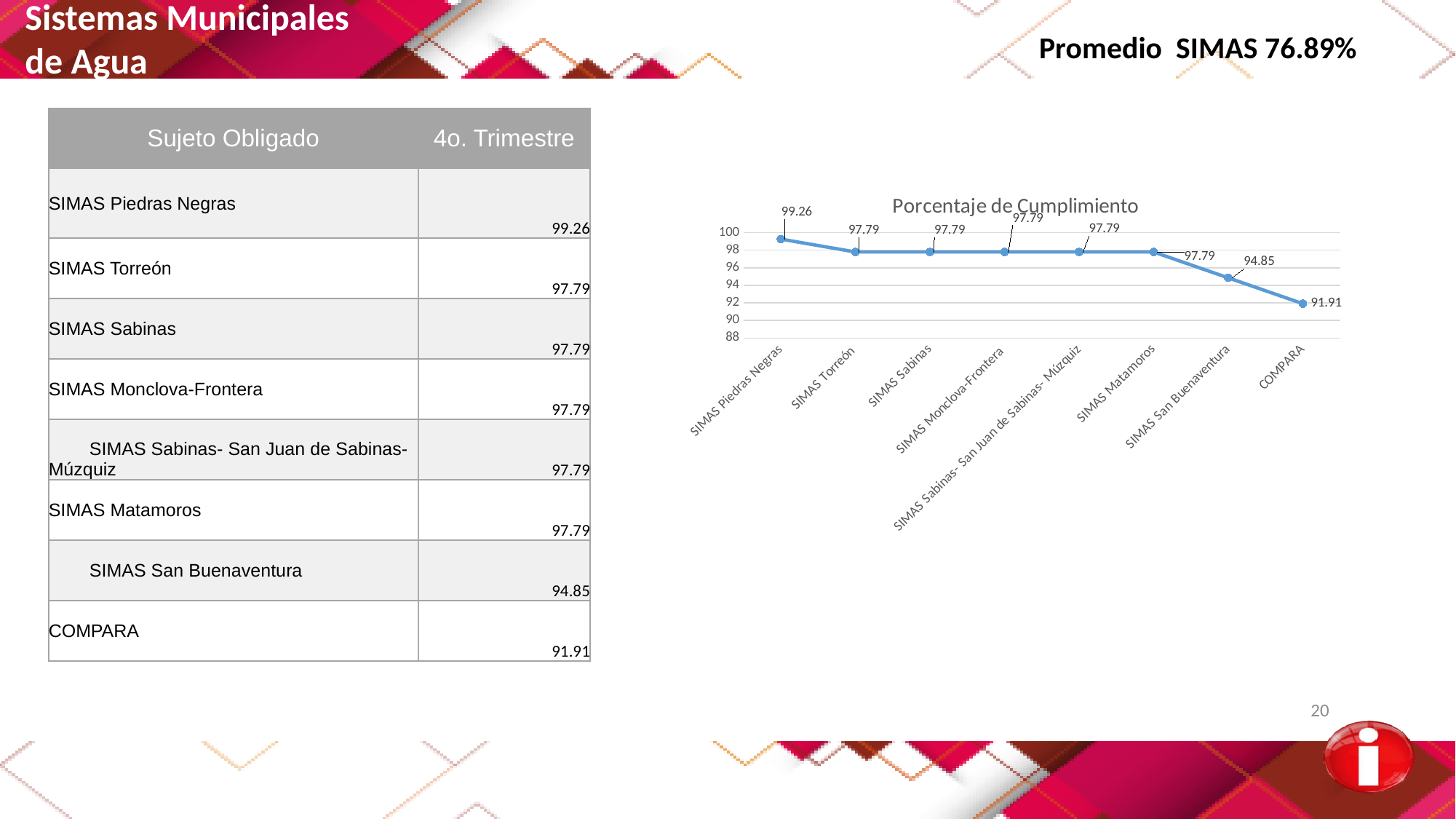
How many categories are plotted in the Porcentaje de Cumplimiento chart? 8 What kind of chart is the Porcentaje de Cumplimiento chart? line chart Which category has the lowest value in the Porcentaje de Cumplimiento chart? COMPARA What is the value for SIMAS San Buenaventura in the Porcentaje de Cumplimiento chart? 94.85 What is the value for SIMAS Piedras Negras in the Porcentaje de Cumplimiento chart? 99.26 What is the difference between the values for SIMAS Piedras Negras and COMPARA in the Porcentaje de Cumplimiento chart? 7.35 Which category has the highest value in the Porcentaje de Cumplimiento chart? SIMAS Piedras Negras Which is larger in the Porcentaje de Cumplimiento chart, the value for SIMAS San Buenaventura or the value for COMPARA? SIMAS San Buenaventura What is the value for SIMAS Torreón in the Porcentaje de Cumplimiento chart? 97.79 What is the value for COMPARA in the Porcentaje de Cumplimiento chart? 91.91 Do the values in the Porcentaje de Cumplimiento chart generally rise or fall from left to right along the x axis? fall What is the difference between the values for SIMAS Matamoros and SIMAS San Buenaventura in the Porcentaje de Cumplimiento chart? 2.94